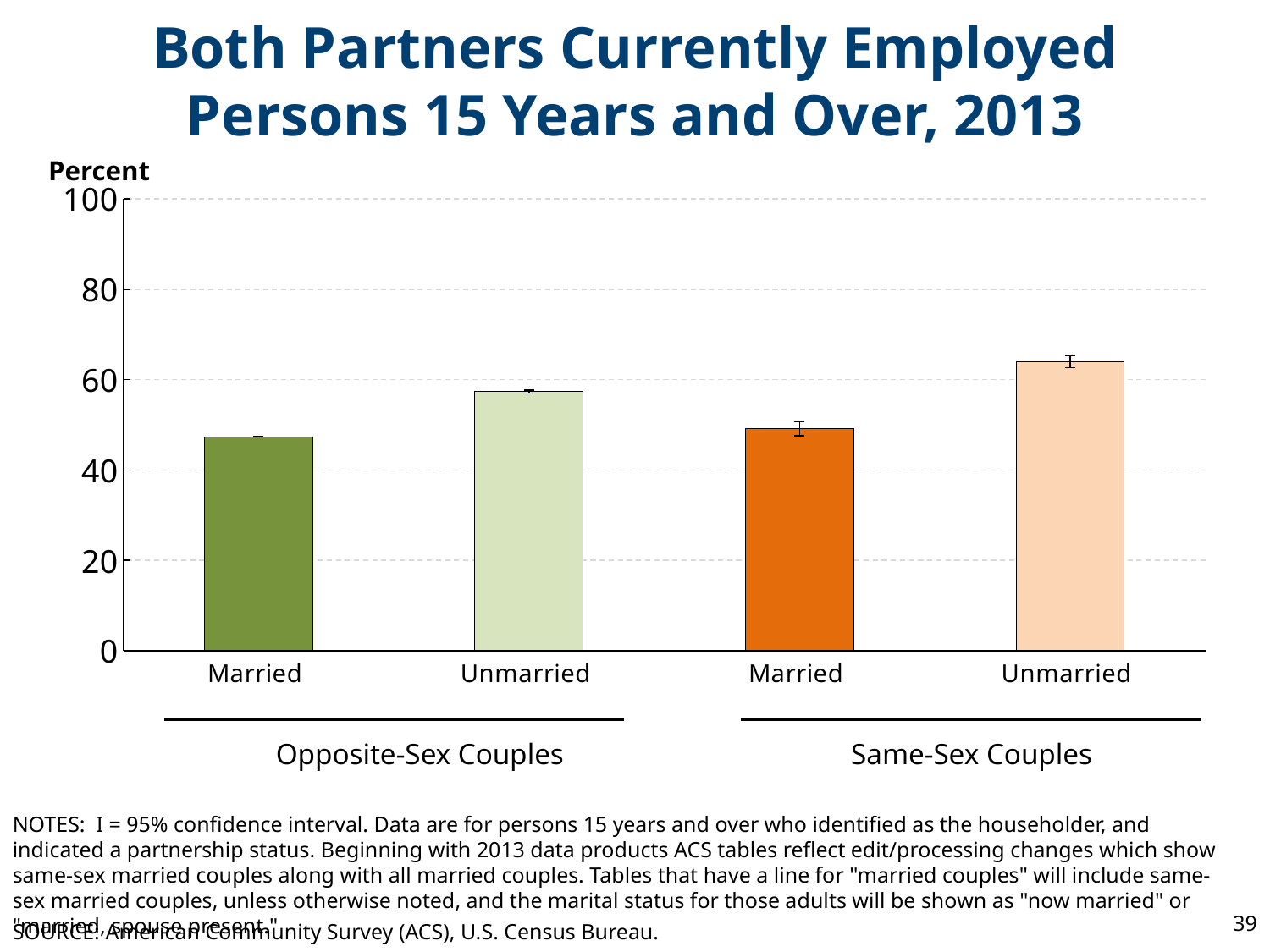
How many bars are plotted in the chart? 4 Is the value for Married Same-Sex Couples greater or less than 60? less Among Opposite-Sex Couples, which is larger: the value for Married or for Unmarried? Unmarried Which bar has the highest value in the chart? Unmarried, Same-Sex Couples Among Same-Sex Couples, which is larger: the value for Married or for Unmarried? Unmarried Which is larger: the Unmarried value for Opposite-Sex Couples or the Unmarried value for Same-Sex Couples? Same-Sex Couples What kind of chart is shown on the slide? bar chart What is the label on the vertical axis of the chart? Percent Is the value for Unmarried Same-Sex Couples greater or less than 60? greater Is the value for Married Opposite-Sex Couples greater or less than 60? less What is the title of the chart? Both Partners Currently Employed Persons 15 Years and Over, 2013